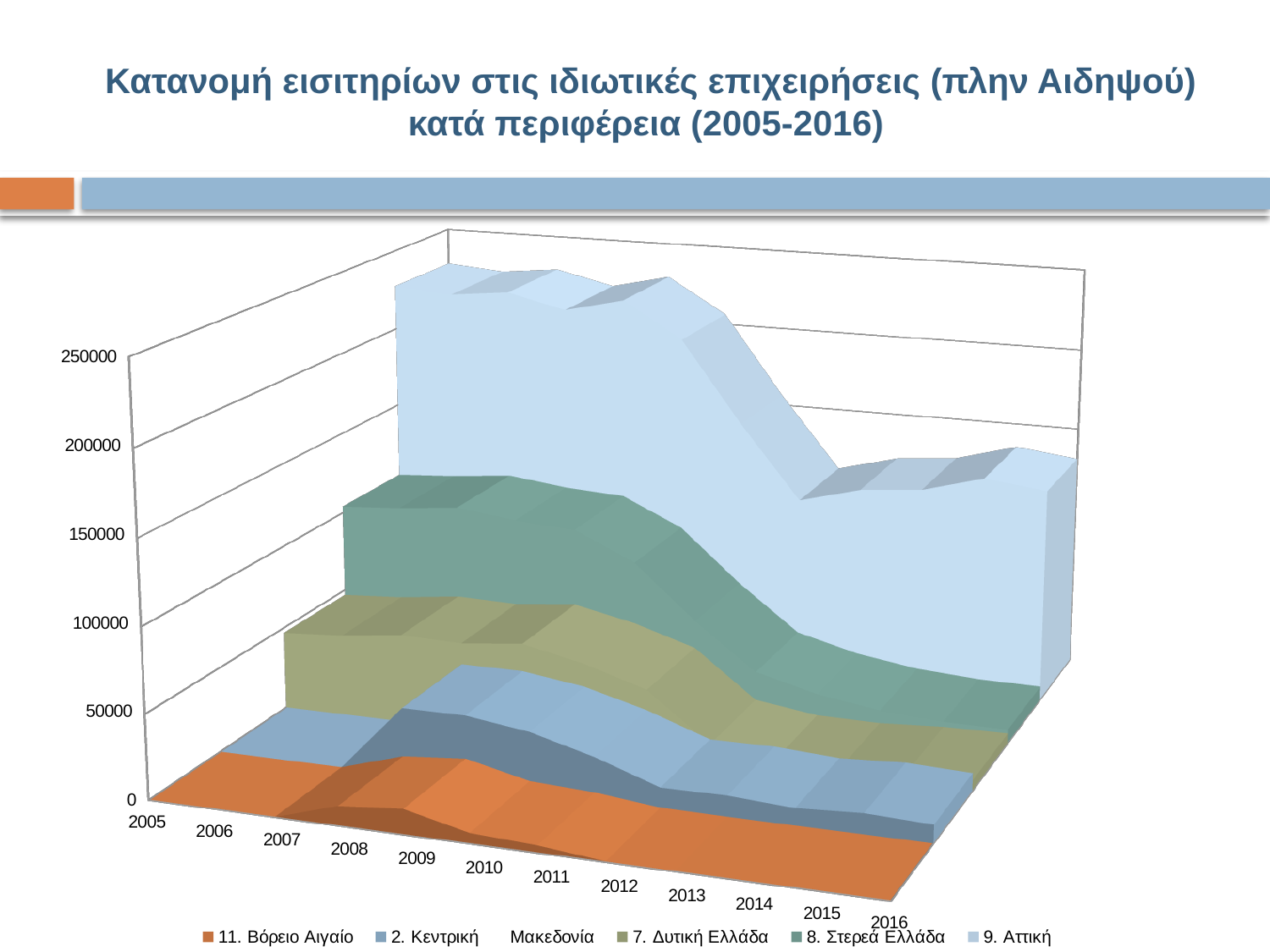
What is the highest value labelled on the vertical axis? 250000 What is the last year shown on the x axis? 2016 How many series does the legend list? 5 How many years are shown along the x axis? 12 What is the first year shown on the x axis? 2005 Does the total stacked value rise or fall from 2008 to 2014? Fall Which series contributes the largest share of the stacked total across the years? 9. Αττική Which series is plotted at the bottom of the stack? 11. Βόρειο Αιγαίο Does the total stacked value rise or fall from 2005 to 2008? Rise What colour represents the series 9. Αττική? Light blue What kind of chart is shown on the slide? Area chart